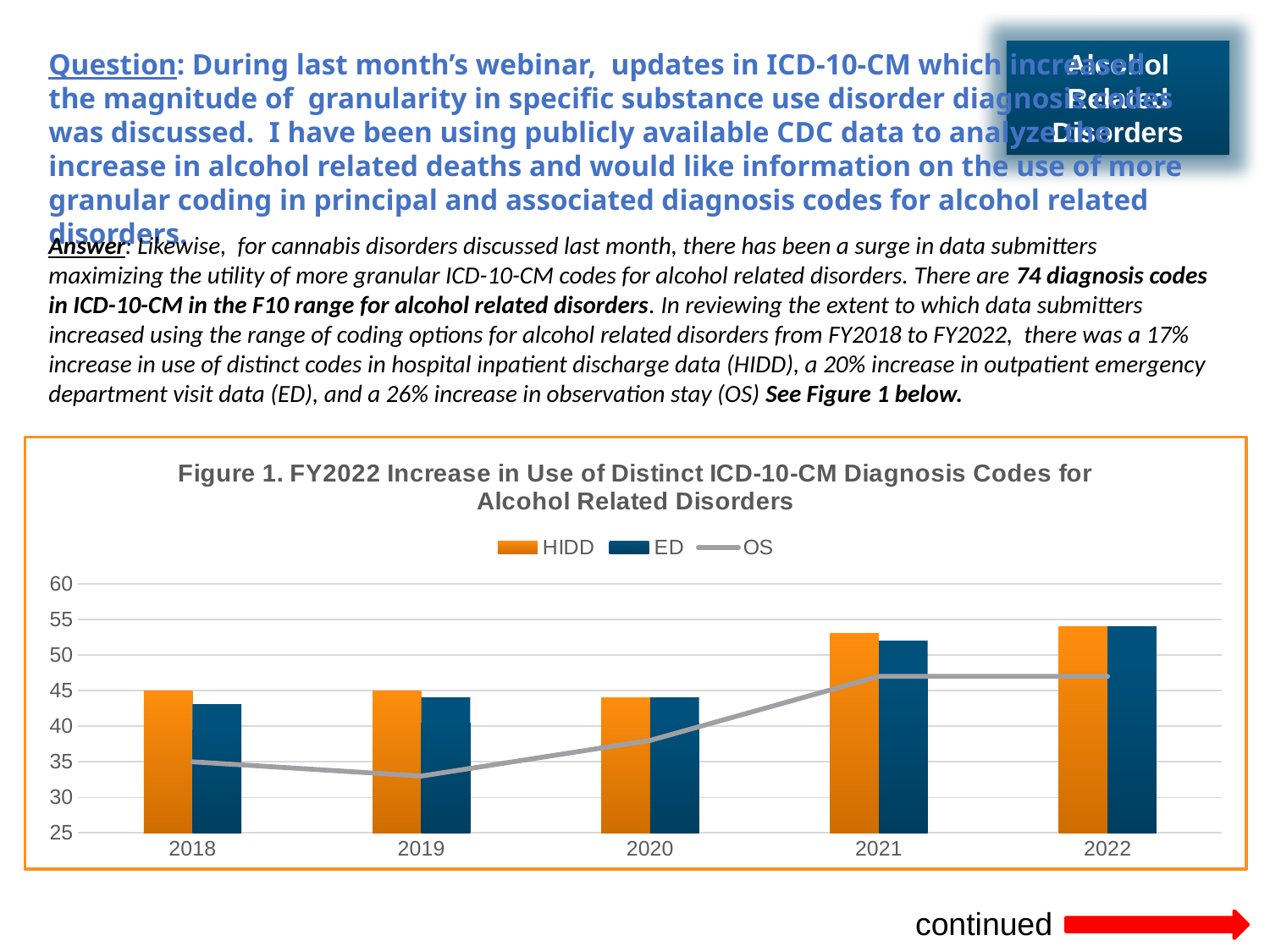
How many series does the legend of Figure 1 list? 3 In Figure 1, is the HIDD value for 2021 greater or less than 50? greater In Figure 1, is the OS value for 2019 greater or less than 35? less What is the title of the chart on the slide? Figure 1. FY2022 Increase in Use of Distinct ICD-10-CM Diagnosis Codes for Alcohol Related Disorders Which series in Figure 1 is drawn as a line rather than bars? OS In Figure 1, is the ED value for 2018 greater or less than 45? less In Figure 1, does the OS line rise or fall from 2019 to 2021? rise In Figure 1, for 2018, which is larger: HIDD or ED? HIDD In Figure 1, which year has the lowest OS value? 2019 How many years are shown on the x axis of Figure 1? 5